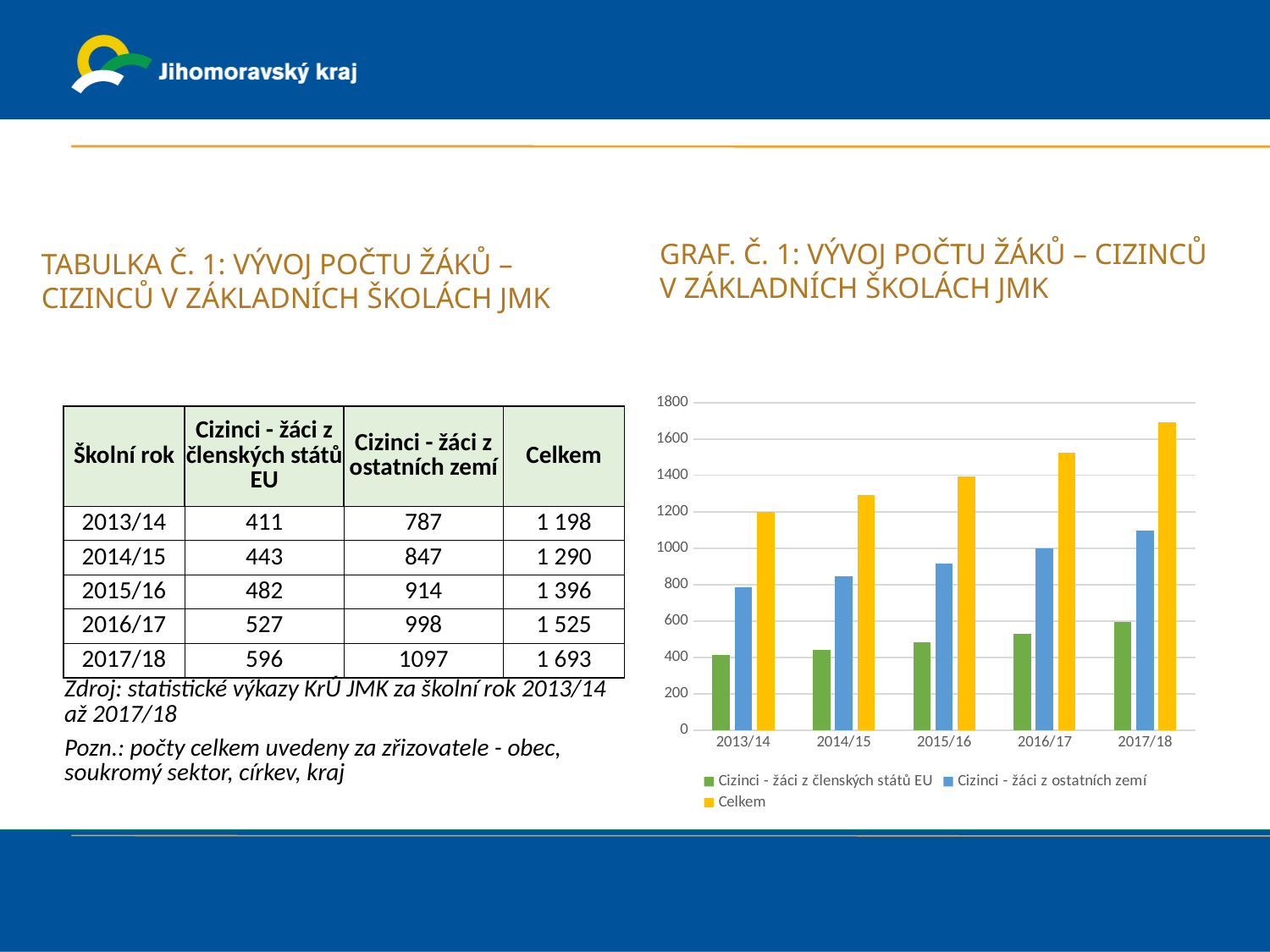
Is the value for Cizinci - žáci z ostatních zemí in 2013/14 greater or less than 800? less Is the value for Celkem in 2015/16 greater or less than 1200? greater Which school year has the lowest value for Cizinci - žáci z členských států EU? 2013/14 Is the value for Cizinci - žáci z členských států EU in 2017/18 greater or less than 600? less How many series does the legend of the chart list? 3 How many school years are shown on the x axis of the chart? 5 Which school year has the highest value for Celkem in the chart? 2017/18 What colour are the Celkem bars in the chart? yellow Which is larger in 2016/17: Cizinci - žáci z ostatních zemí or Cizinci - žáci z členských států EU? Cizinci - žáci z ostatních zemí Does the value for Celkem rise or fall from 2013/14 to 2017/18? rise According to the table on the slide, what is the value for Celkem in 2014/15? 1 290 What kind of chart is Graf č. 1 on the slide? bar chart